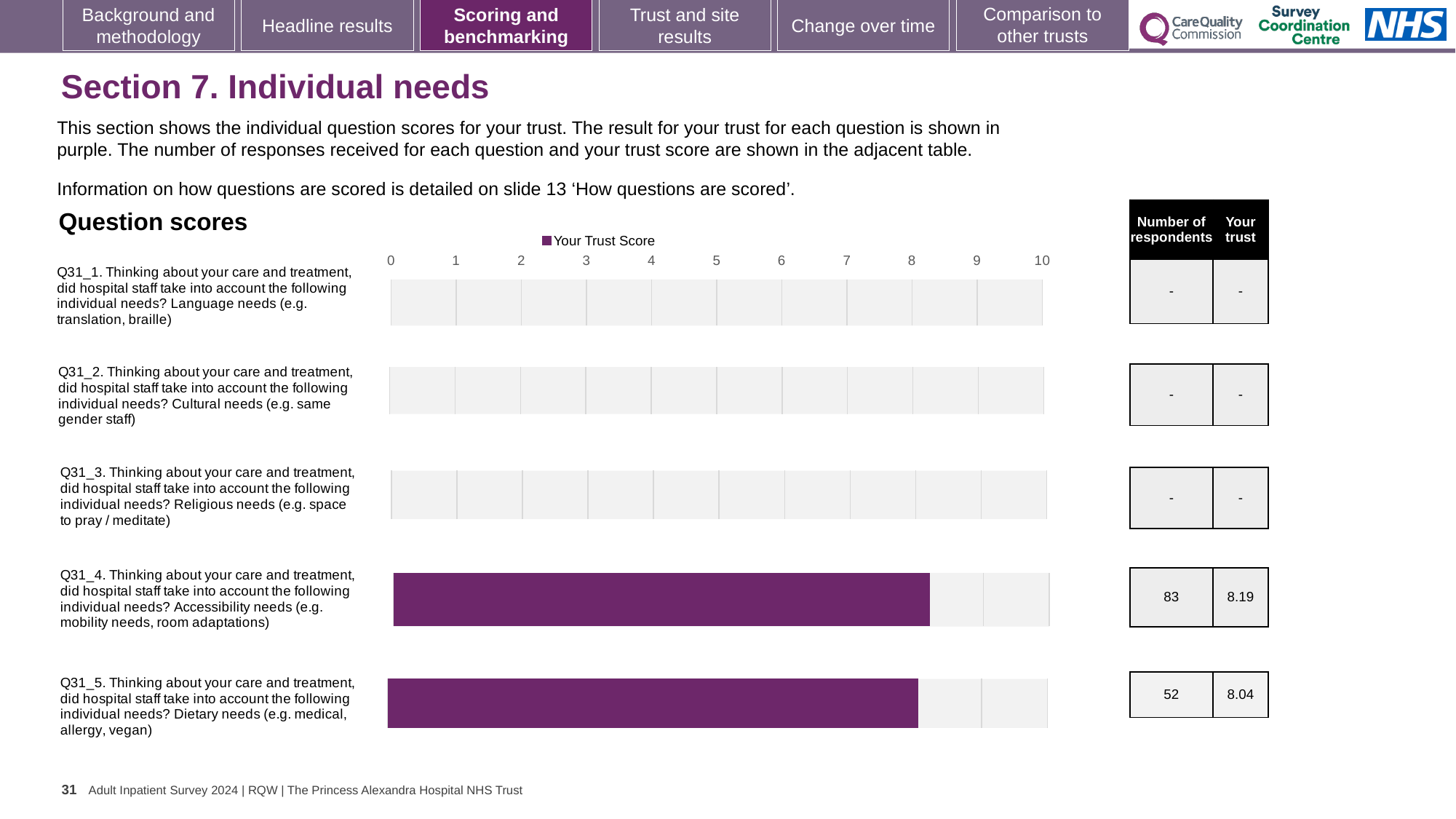
How many questions are listed in the Question scores chart? 5 How many respondents answered Q31_5 (Dietary needs)? 52 How many series does the legend of the Question scores chart list? 1 What kind of chart is used to show the question scores? Bar chart Which question has the higher trust score, Q31_4 (Accessibility needs) or Q31_5 (Dietary needs)? Q31_4 What is the difference between the trust scores for Q31_4 (Accessibility needs) and Q31_5 (Dietary needs)? 0.15 What is the trust score for Q31_5 (Dietary needs)? 8.04 What is the legend entry shown above the Question scores chart? Your Trust Score Is the trust score bar for Q31_4 (Accessibility needs) greater or less than 9? less Is the trust score bar for Q31_5 (Dietary needs) greater or less than 7? greater What is the trust score for Q31_4 (Accessibility needs)? 8.19 How many respondents answered Q31_4 (Accessibility needs)? 83